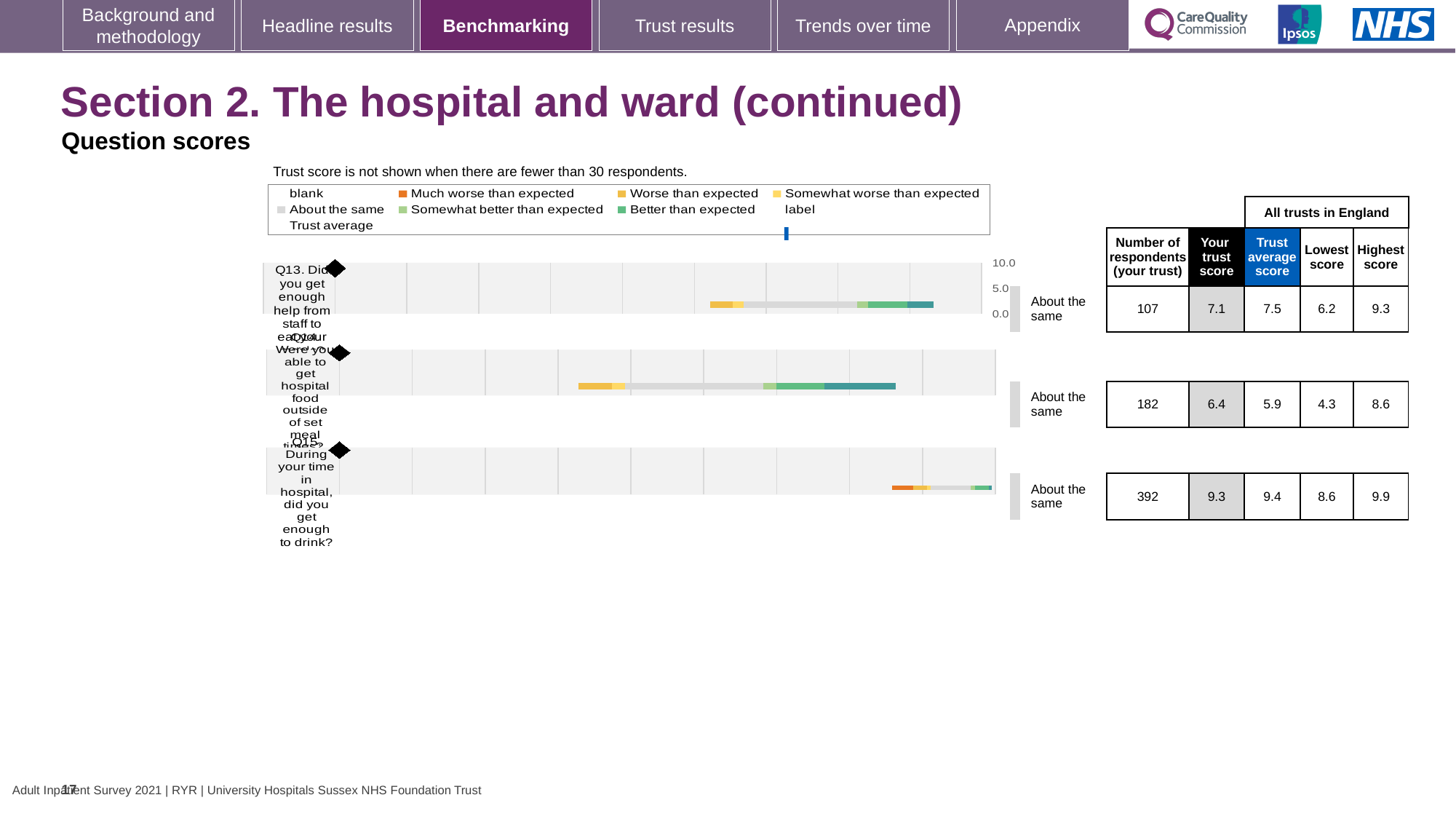
What benchmark category is shown next to the Q13 bar? About the same What is the number of respondents for Q15? 392 What is the lowest score across all trusts in England for Q14? 4.3 What kind of chart is used to show the question scores on this slide? bar chart What is the trust average score for Q15 (did you get enough to drink?)? 9.4 Which question has the highest trust score? Q15 For Q13, what is the difference between the trust average score and the trust score? 0.4 Which question has the lowest trust score? Q14 What is the trust score for Q14 (Were you able to get hospital food outside of set meal times?)? 6.4 What is the number of respondents for Q13 (Did you get enough help from staff to eat your meals?)? 107 How many questions (Q13, Q14, Q15) are plotted on the slide? 3 For Q14, which is larger: the trust score or the trust average score? the trust score